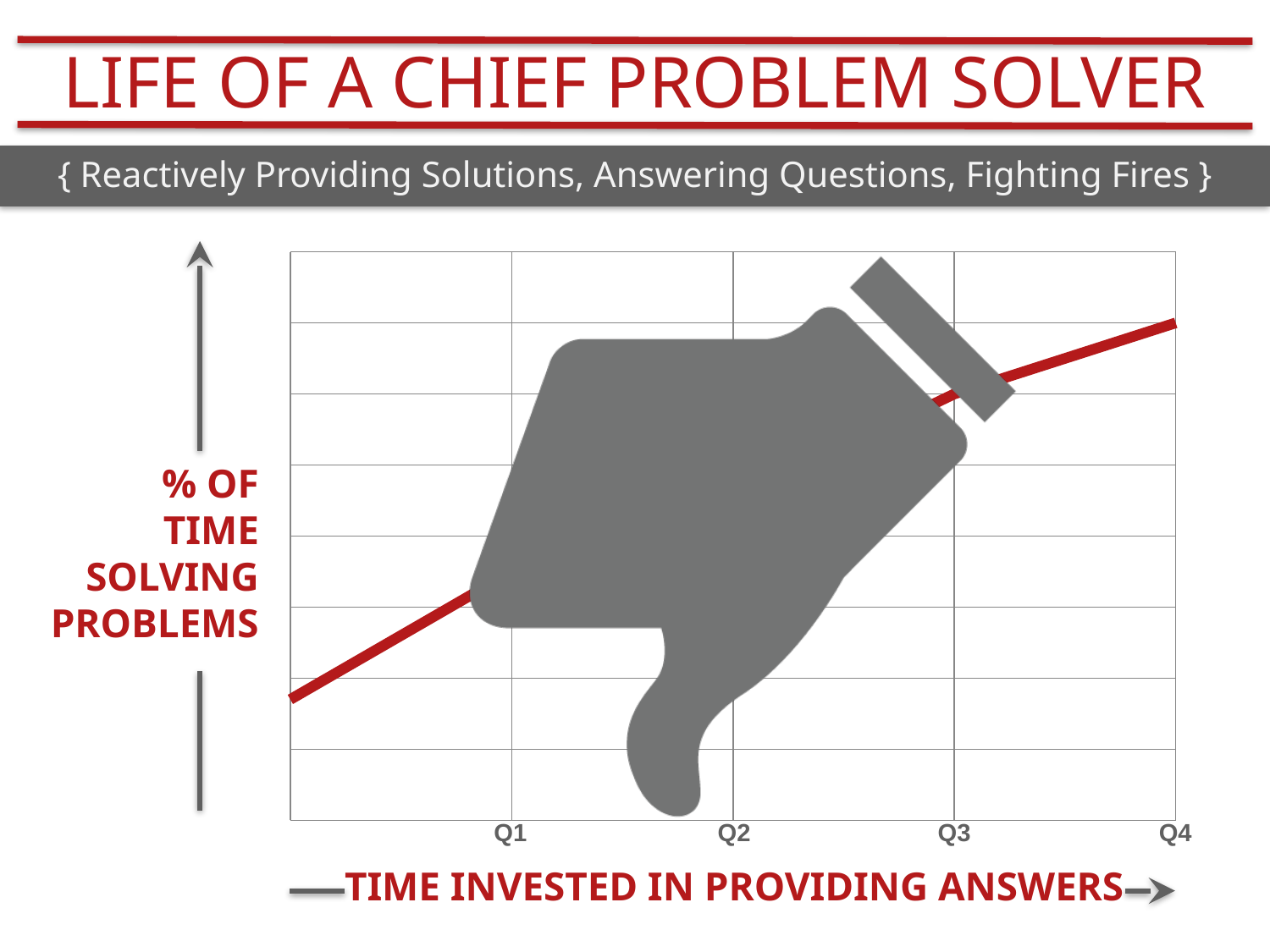
Is the value of the red line larger at Q3 or at Q2? Q3 At which labelled quarter is the red line lowest? Q1 Is the value of the red line larger at Q4 or at Q1? Q4 What is the label on the y axis of the chart? % OF TIME SOLVING PROBLEMS At which labelled quarter is the red line highest? Q4 How many quarters are labelled on the x axis? 4 Does the red line rise or fall from Q1 to Q4? rise What kind of chart is shown on the slide? line chart What is the label on the x axis of the chart? TIME INVESTED IN PROVIDING ANSWERS